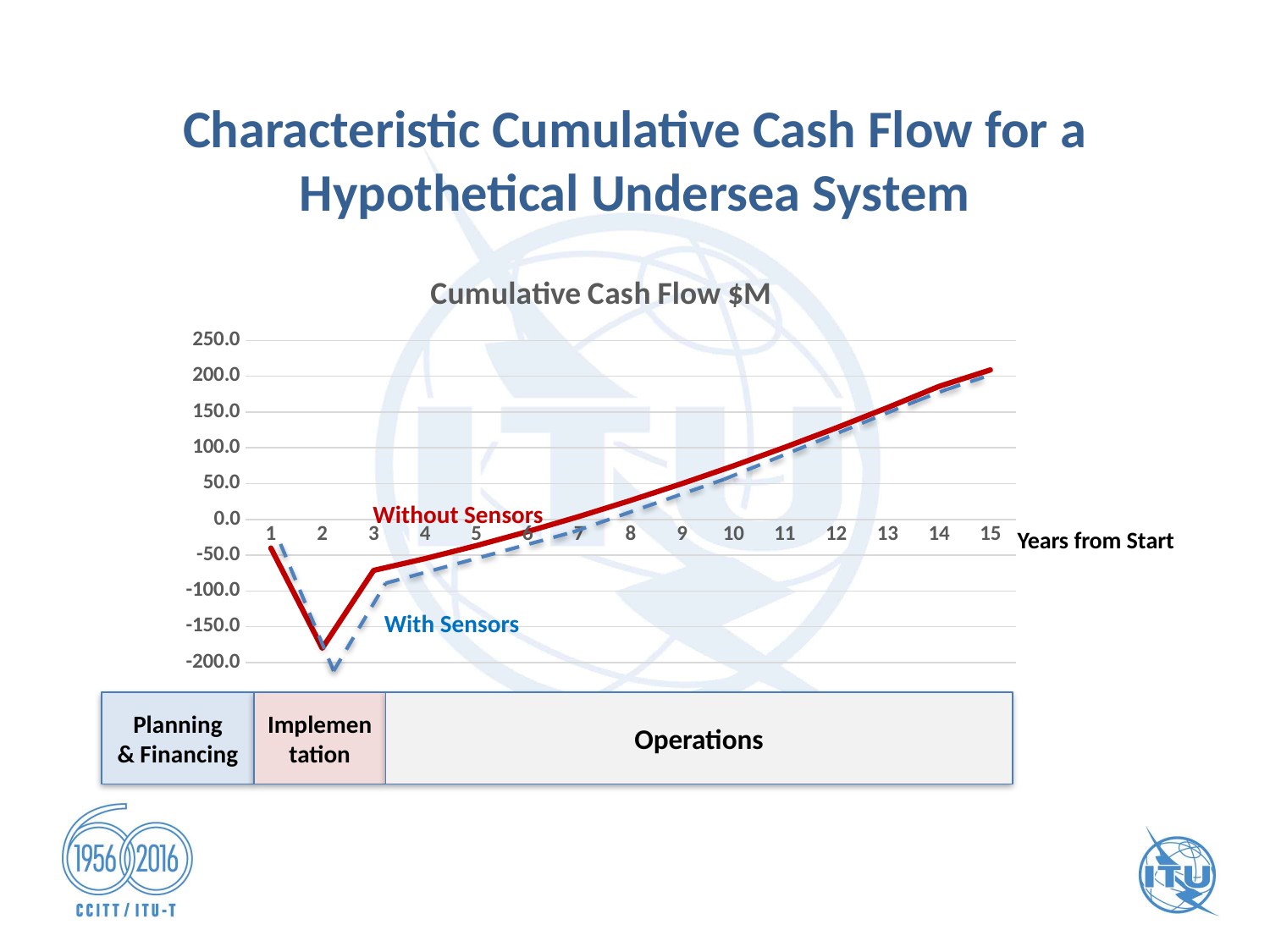
Is the value for Without Sensors in year 2 greater or less than -150.0? less In which year does the Without Sensors line reach its lowest value? 2 What is the title of the chart? Cumulative Cash Flow $M From year 3 to year 15, do the cumulative cash flow values rise or fall? rise At year 2, which series has the lower value, Without Sensors or With Sensors? With Sensors Is the value for With Sensors in year 3 greater or less than -50.0? less How many series are plotted on the chart? 2 What kind of chart is shown on the slide? line chart Is the value for Without Sensors in year 12 greater or less than 100.0? greater How many years are shown along the x axis of the chart? 15 What is the label of the x axis? Years from Start